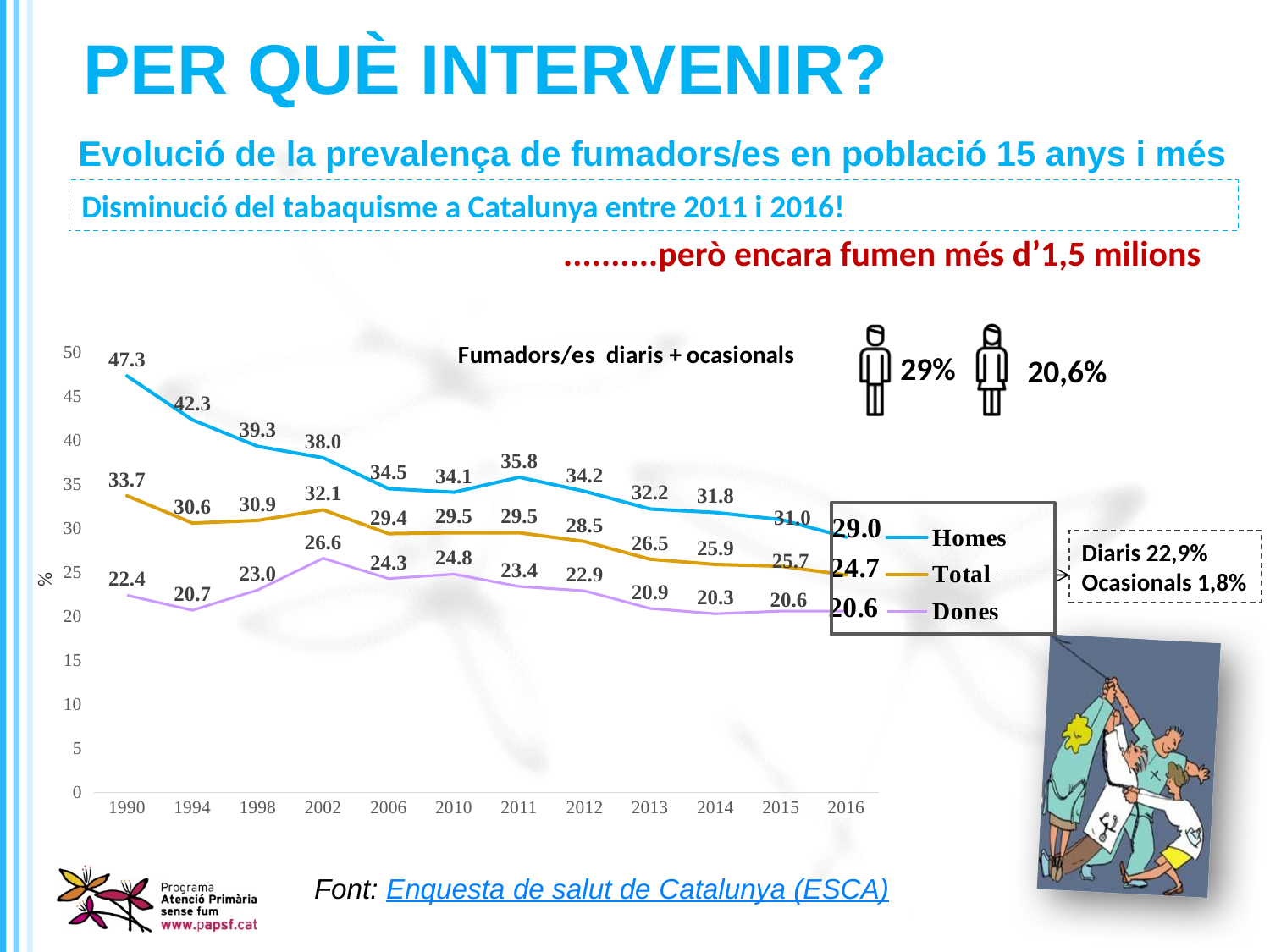
How many series does the chart legend list? 3 What is the value for Dones in 2002? 26.6 Which is larger, the Total value in 2002 or the Total value in 2006? 2002 What is the difference between the Homes and Dones values in 2016? 8.4 Does the Homes series generally rise or fall from 1990 to 2016? fall What is the title printed inside the chart area? Fumadors/es diaris + ocasionals What type of chart is shown on the slide? line chart What is the value for Homes in 1990? 47.3 What is the value for Total in 2016? 24.7 In which year is the Homes series at its highest? 1990 In which year is the Dones series at its lowest? 2014 How many years are plotted along the x axis of the chart? 12